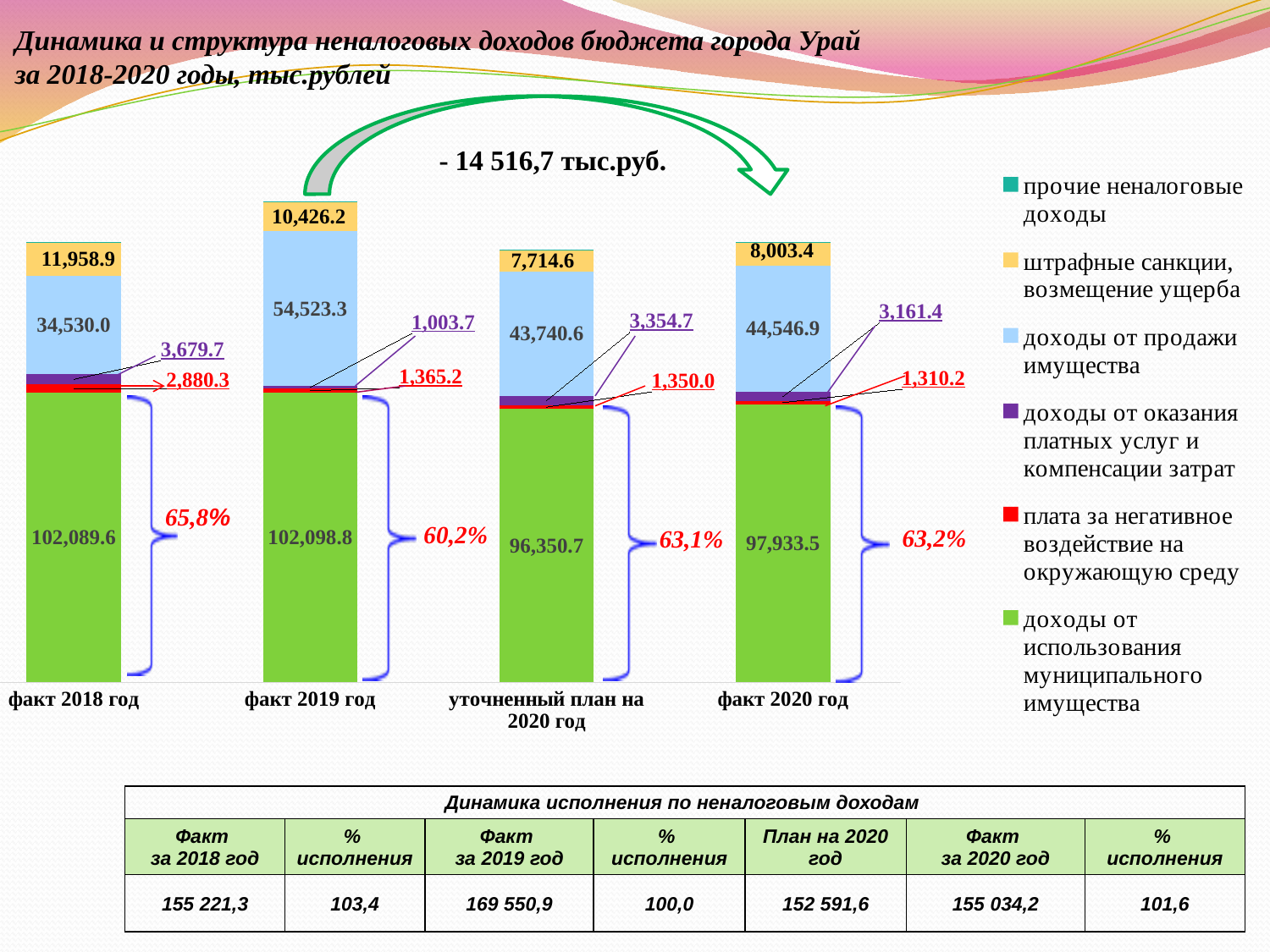
How many series does the chart legend list? 6 What is the difference between 'штрафные санкции, возмещение ущерба' for 'факт 2018 год' and for 'факт 2019 год'? 1,532.7 How many bars (categories) are shown on the x axis of the chart? 4 What is the value of 'плата за негативное воздействие на окружающую среду' for 'факт 2018 год'? 2,880.3 Which is larger: 'доходы от использования муниципального имущества' for 'факт 2018 год' or for 'факт 2019 год'? факт 2019 год What is the value of 'доходы от продажи имущества' for 'факт 2019 год'? 54,523.3 What kind of chart is shown on the slide? Stacked bar chart What is the value of 'штрафные санкции, возмещение ущерба' for 'факт 2020 год'? 8,003.4 What percentage is shown next to the 'факт 2018 год' bar? 65,8% What is the value of 'доходы от оказания платных услуг и компенсации затрат' for 'уточненный план на 2020 год'? 3,354.7 Which category has the highest value for 'доходы от продажи имущества'? факт 2019 год Which category has the lowest value for 'штрафные санкции, возмещение ущерба'? уточненный план на 2020 год